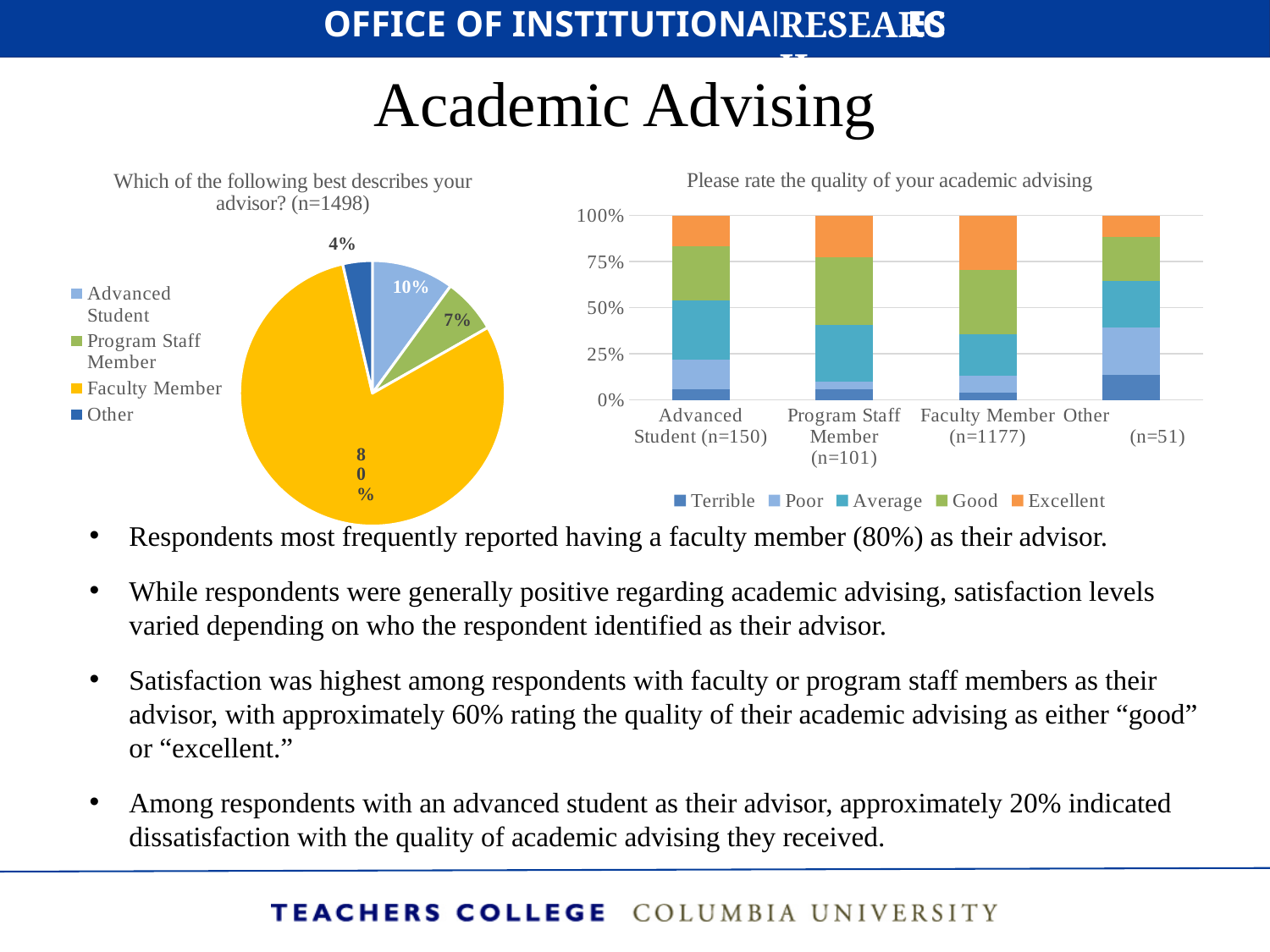
In the pie chart on the left, what share of respondents have an Advanced Student as their advisor? 10% How many slices does the pie chart on the left have? 4 In the pie chart on the left, which advisor type has the largest slice? Faculty Member How many advisor categories are shown on the x axis of the chart 'Please rate the quality of your academic advising'? 4 In the pie chart on the left, how many percentage points larger is the Faculty Member share than the Advanced Student share? 70 In the chart 'Please rate the quality of your academic advising', which advisor category has the largest 'Poor' segment? Other In the pie chart on the left, what share of respondents have a Program Staff Member as their advisor? 7% In the pie chart on the left, which advisor type has the smallest slice? Other What type of chart is the chart on the left of the slide? Pie chart In the pie chart 'Which of the following best describes your advisor?', what percentage of respondents reported a Faculty Member as their advisor? 80% How many series does the legend of the chart 'Please rate the quality of your academic advising' list? 5